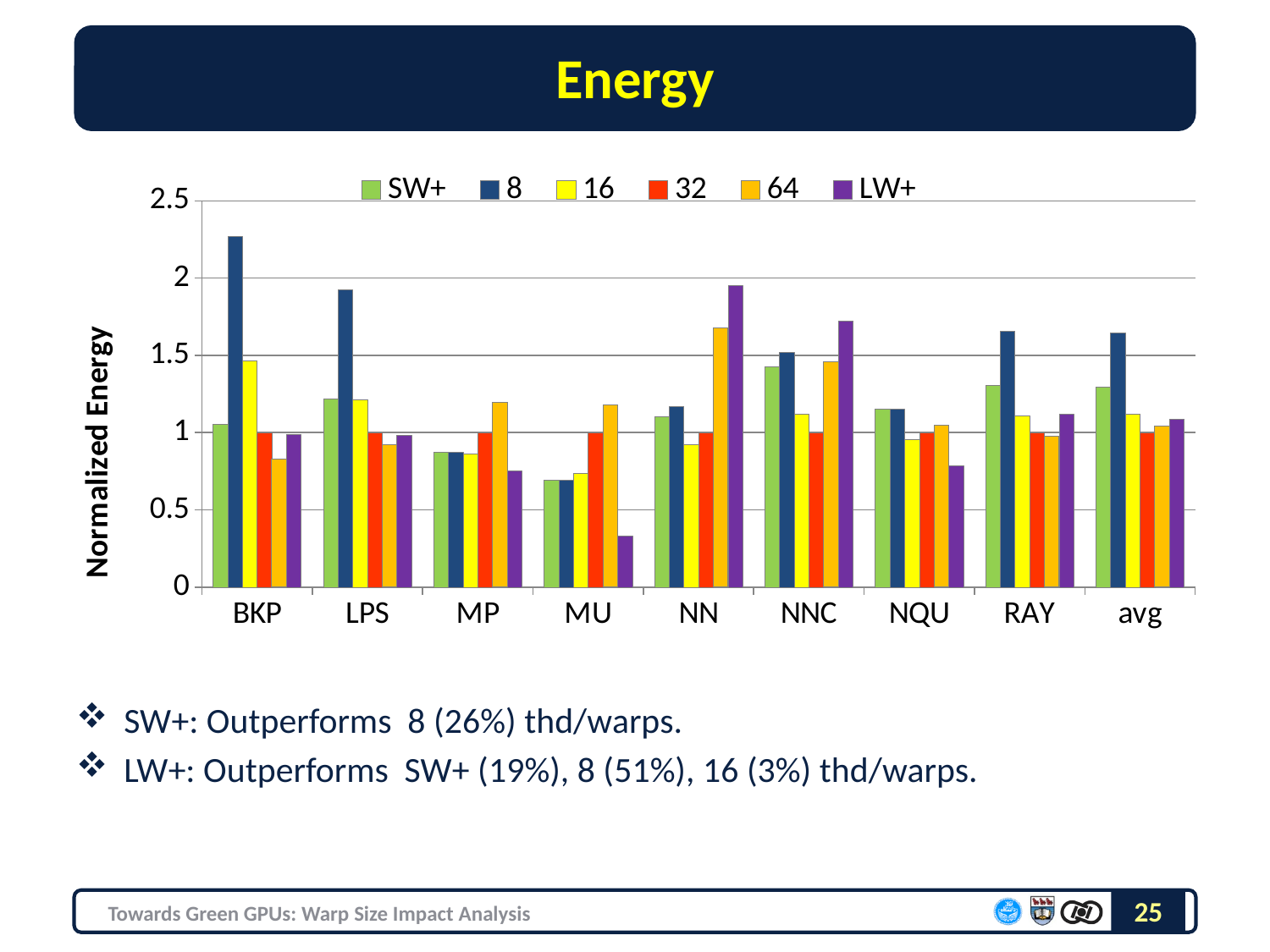
How many categories are shown along the x axis? 9 Which series has the lowest value for MU? LW+ What kind of chart is shown on the slide? bar chart For avg, which is larger: the value of the 8 series or the value of the LW+ series? 8 For NQU, which is larger: the value of the SW+ series or the value of the LW+ series? SW+ Which series has the highest value for NN? LW+ Is the value of the 8 series for BKP greater or less than 2? greater What is the label of the y axis? Normalized Energy Which series has the highest value for BKP? 8 Is the value of the 8 series for LPS greater or less than 1.5? greater How many series does the legend list? 6 Is the value of the LW+ series for MU greater or less than 0.5? less